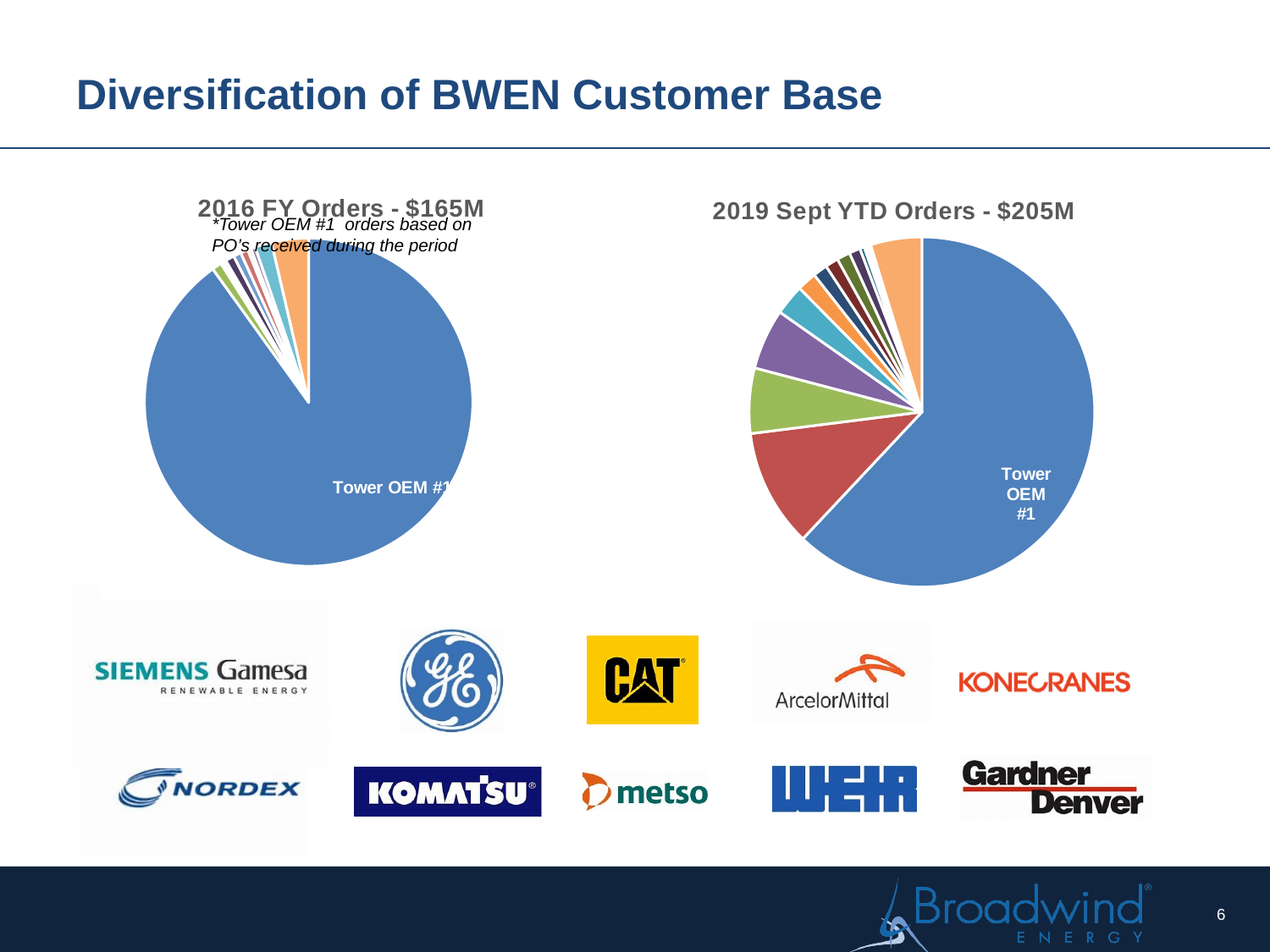
In which chart does Tower OEM #1 take a larger share of the pie, 2016 FY Orders or 2019 Sept YTD Orders? 2016 FY Orders In the 2016 FY Orders chart, which customer has the largest slice? Tower OEM #1 In the 2019 Sept YTD Orders chart, which customer has the largest slice? Tower OEM #1 What is the title of the pie chart on the left side of the slide? 2016 FY Orders - $165M What total order value is shown in the title of the 2016 FY Orders chart? $165M What is the difference between the total orders in the 2019 Sept YTD Orders chart and the 2016 FY Orders chart? $40M What kind of chart is used on this slide to show the 2016 FY Orders? Pie chart What kind of chart is used on this slide to show the 2019 Sept YTD Orders? Pie chart In the 2019 Sept YTD Orders chart, is the share of Tower OEM #1 greater or less than 50%? greater What total order value is shown in the title of the 2019 Sept YTD Orders chart? $205M In the 2016 FY Orders chart, is the share of Tower OEM #1 greater or less than 50%? greater Which chart shows the larger total orders, 2016 FY Orders or 2019 Sept YTD Orders? 2019 Sept YTD Orders